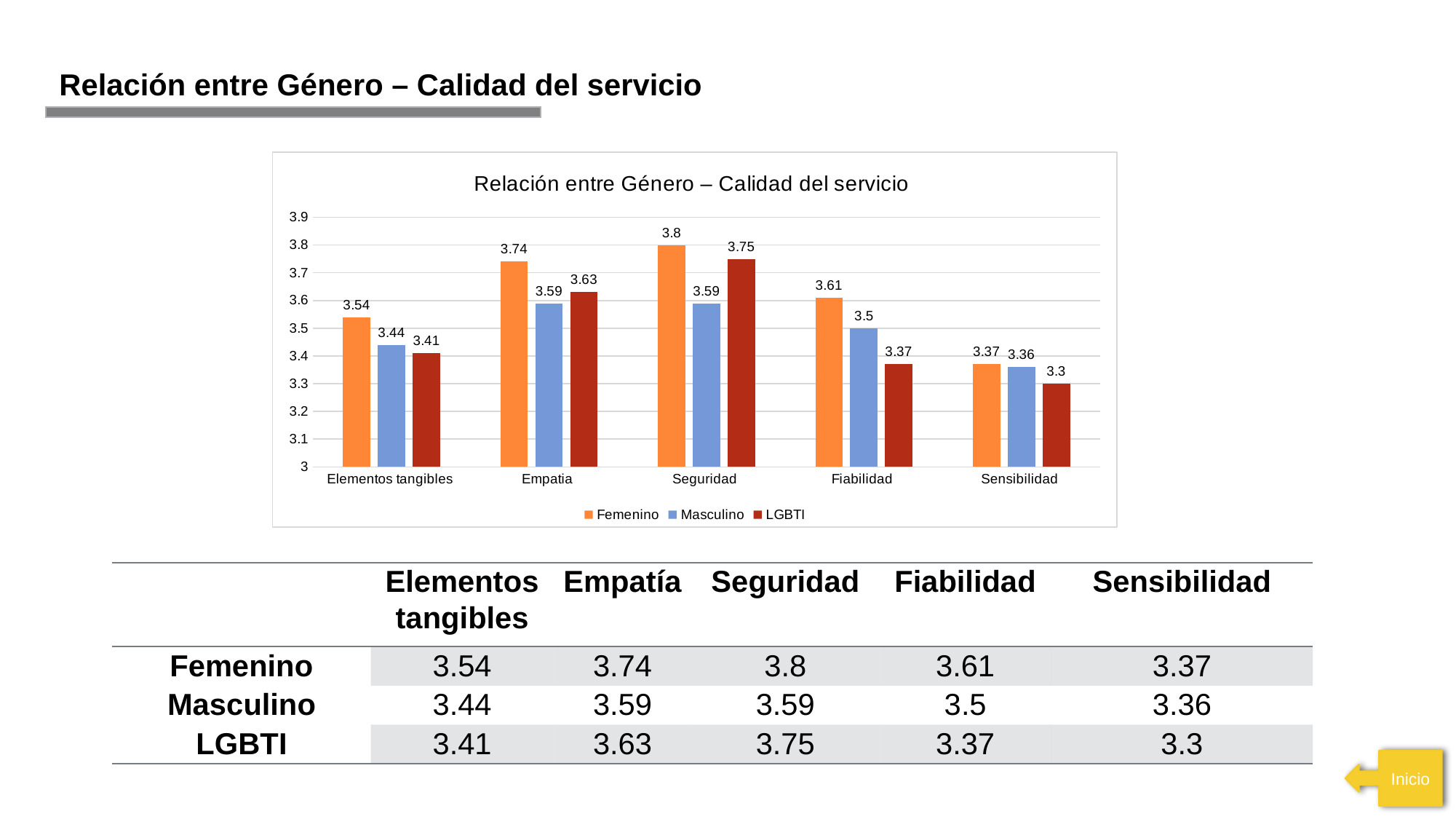
What is the Femenino value for Seguridad? 3.8 What is the LGBTI value for Empatia? 3.63 Which category has the highest Femenino value? Seguridad What is the difference between the Femenino and Masculino values for Elementos tangibles? 0.1 Is the Femenino value for Empatia greater or less than 3.7? greater What is the Masculino value for Fiabilidad? 3.5 What kind of chart is shown? bar chart How many categories are shown on the x axis? 5 Which is larger for Fiabilidad, the Masculino value or the LGBTI value? Masculino Which category has the lowest LGBTI value? Sensibilidad Which series is shown in orange? Femenino How many series does the legend list? 3